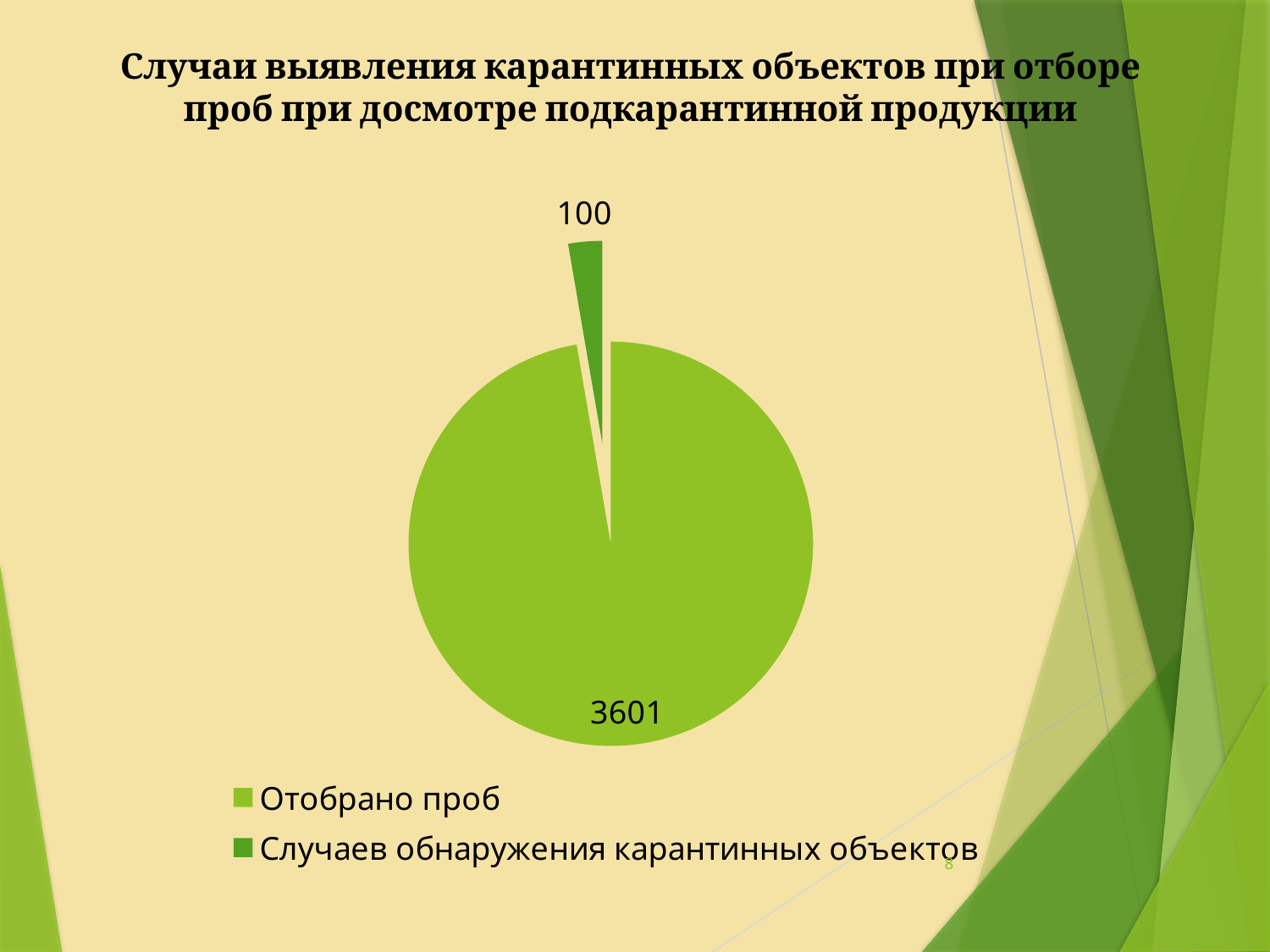
What type of chart is shown on the slide? pie chart Which category has the smallest slice of the pie? Случаев обнаружения карантинных объектов What is the difference between the value for "Отобрано проб" and the value for "Случаев обнаружения карантинных объектов"? 3501 What is the value for "Отобрано проб"? 3601 How many slices does the pie chart have? 2 Which category has the largest slice of the pie? Отобрано проб What is the total of the two values shown in the pie chart? 3701 How many entries does the legend list? 2 Which legend entry is shown in the darker green colour? Случаев обнаружения карантинных объектов Which is larger: the value for "Отобрано проб" or the value for "Случаев обнаружения карантинных объектов"? Отобрано проб What is the value for "Случаев обнаружения карантинных объектов"? 100 What is the title of the chart on the slide? Случаи выявления карантинных объектов при отборе проб при досмотре подкарантинной продукции